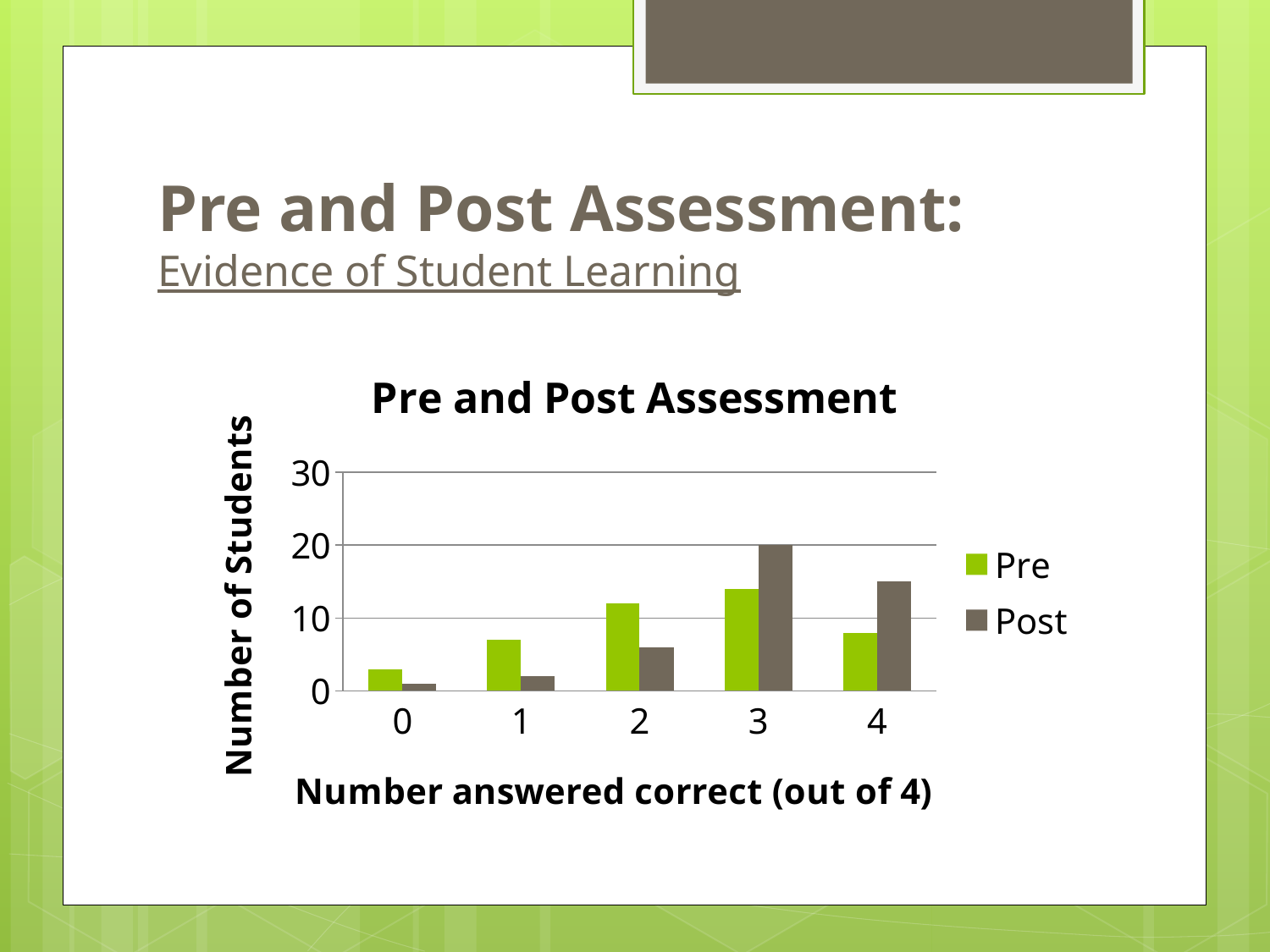
What is the label of the y axis? Number of Students For 4 answered correct, which is larger, Pre or Post? Post Which category has the highest Pre value? 3 Which category has the lowest Post value? 0 How many series does the legend list? 2 What kind of chart is shown on the slide? bar chart How many categories are shown on the x axis? 5 What is the Post value for 3 answered correct? 20 Which category has the highest Post value? 3 What is the title of the chart? Pre and Post Assessment Is the Post value for 4 answered correct greater or less than 10? greater Is the Pre value for 2 answered correct greater or less than 10? greater